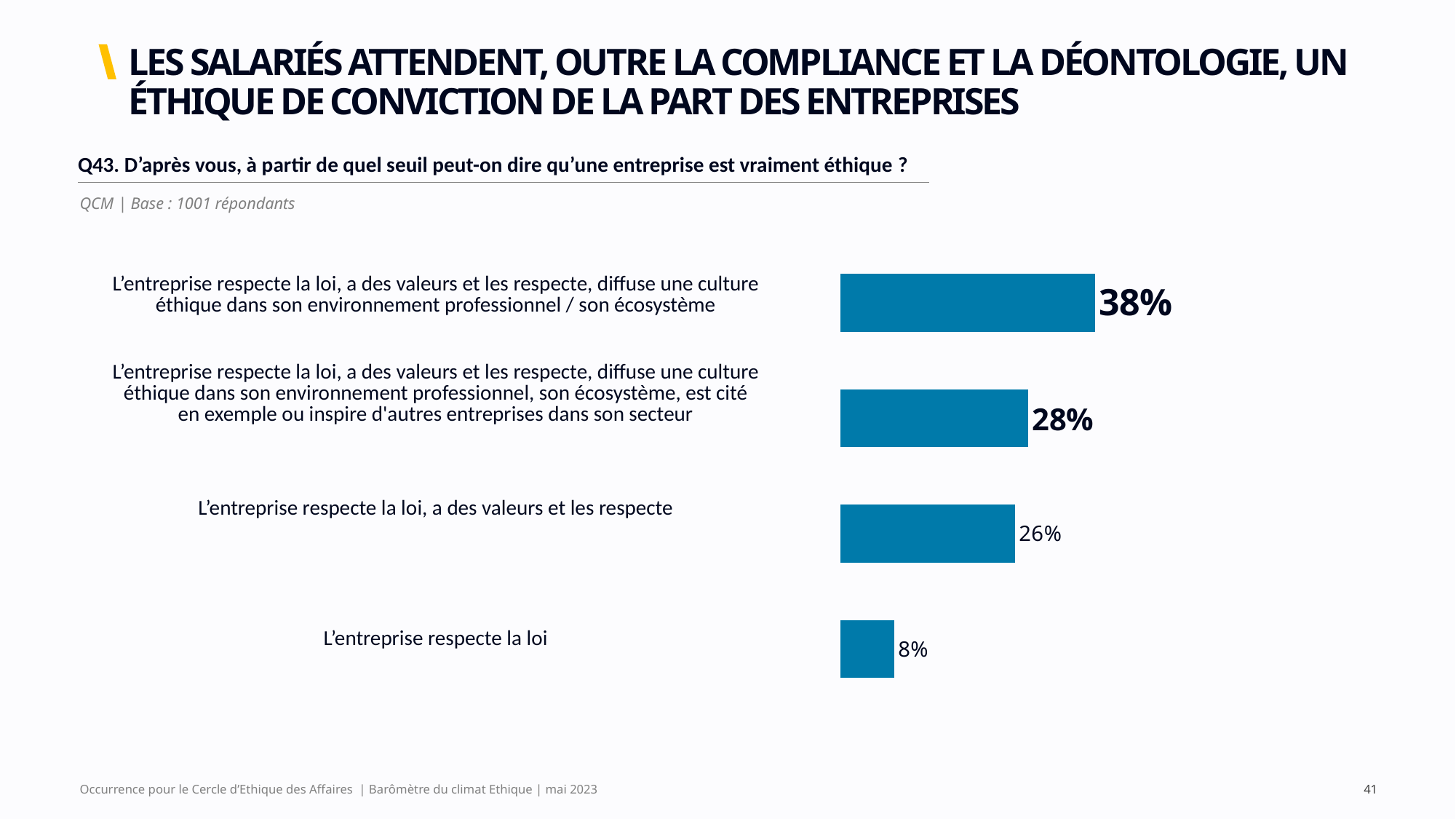
What is the value for "L'entreprise respecte la loi, a des valeurs et les respecte"? 26% What type of chart is shown on the slide? Bar chart Which is larger: the value for "L'entreprise respecte la loi, a des valeurs et les respecte" or the value for "L'entreprise respecte la loi"? L'entreprise respecte la loi, a des valeurs et les respecte What percentage of respondents chose "L'entreprise respecte la loi" as the threshold for a truly ethical company? 8% How many respondents form the base for this question? 1001 répondants How many response options are shown in the chart? 4 Which option has the lowest percentage? L'entreprise respecte la loi What percentage is shown for the option "L'entreprise respecte la loi, a des valeurs et les respecte, diffuse une culture éthique dans son environnement professionnel / son écosystème"? 38% What is the value for the option that includes being cited as an example or inspiring other companies in its sector? 28% Which option has the highest percentage? L'entreprise respecte la loi, a des valeurs et les respecte, diffuse une culture éthique dans son environnement professionnel / son écosystème What is the difference between the 28% option and the 26% option? 2 percentage points What is the difference in percentage points between the highest option (38%) and "L'entreprise respecte la loi" (8%)? 30 percentage points